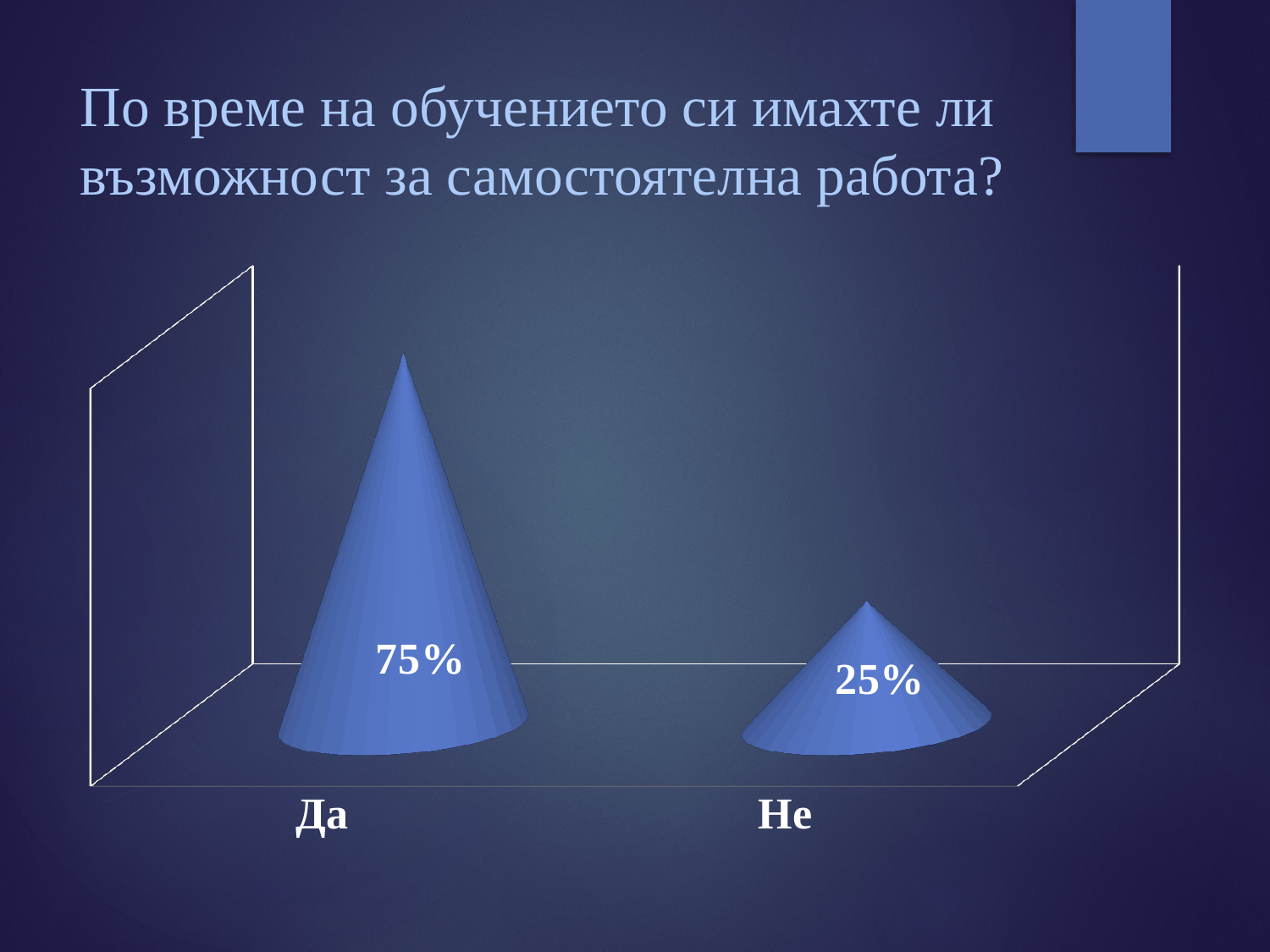
What is the value for Да? 75% Which category has the highest value? Да What is the value for Не? 25% What is the title of the slide containing the chart? По време на обучението си имахте ли възможност за самостоятелна работа? What colour are the bars in the chart? Blue Which category has the lowest value? Не Which is larger, the value for Да or the value for Не? Да How many categories are shown in the chart? 2 What is the difference between the values for Да and Не? 50% What kind of chart is shown on the slide? Bar chart What is the total of the two values shown in the chart? 100%